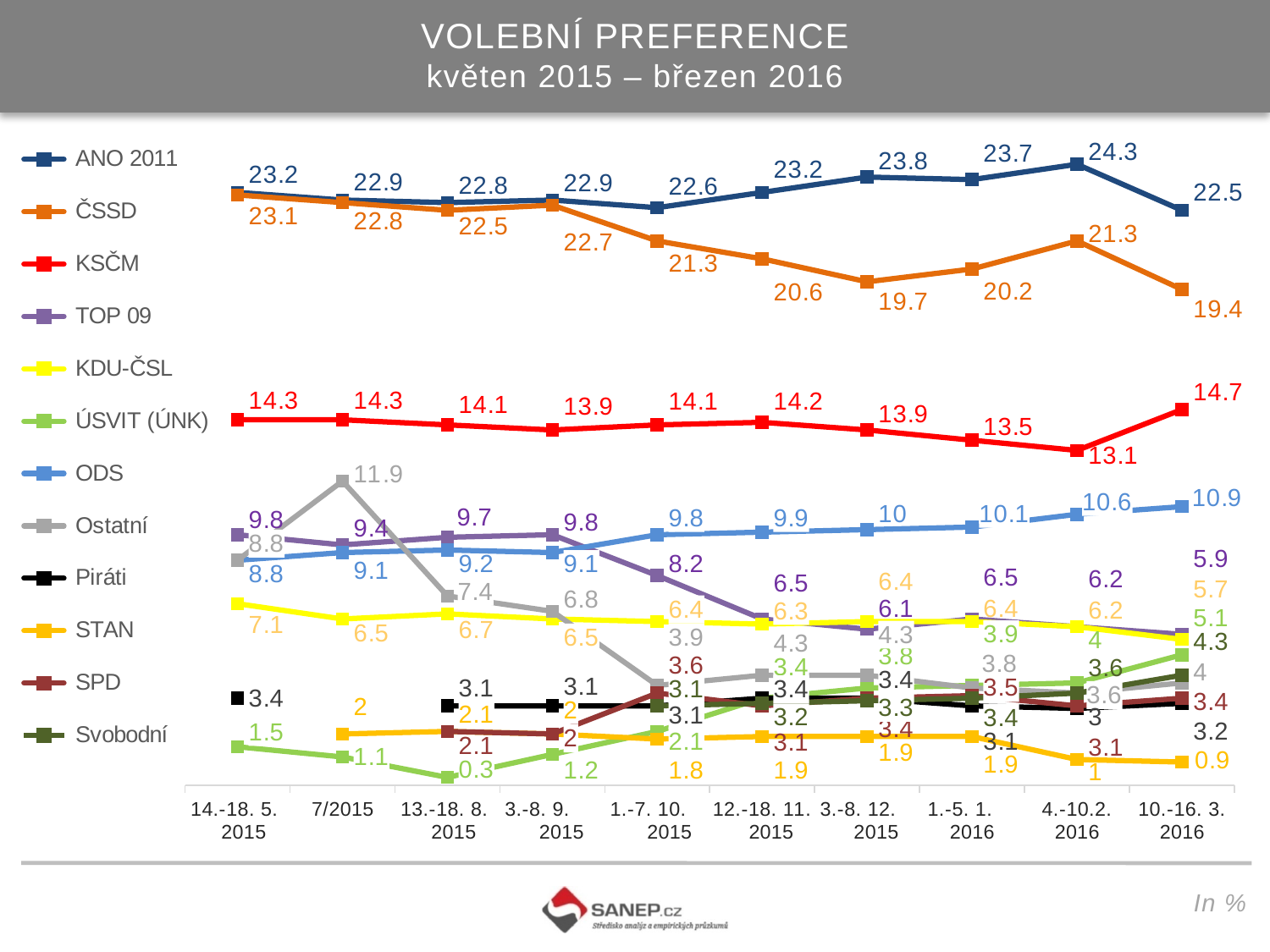
In which period does ČSSD have its lowest value? 10.-16. 3. 2016 What is the value for Ostatní in the period 7/2015? 11.9 How many series does the legend list? 12 What kind of chart is shown on the slide? line chart Which is higher in the period 10.-16. 3. 2016, ODS or TOP 09? ODS What is the value for KSČM in the period 10.-16. 3. 2016? 14.7 In which period does ANO 2011 reach its highest value? 4.-10.2. 2016 What is the difference between ANO 2011 and ČSSD in the period 10.-16. 3. 2016? 3.1 Does the ODS line generally rise or fall from May 2015 to March 2016? rise How many survey periods are shown along the x axis? 10 What is the value for ANO 2011 in the period 4.-10.2. 2016? 24.3 What is the value for ČSSD in the period 10.-16. 3. 2016? 19.4